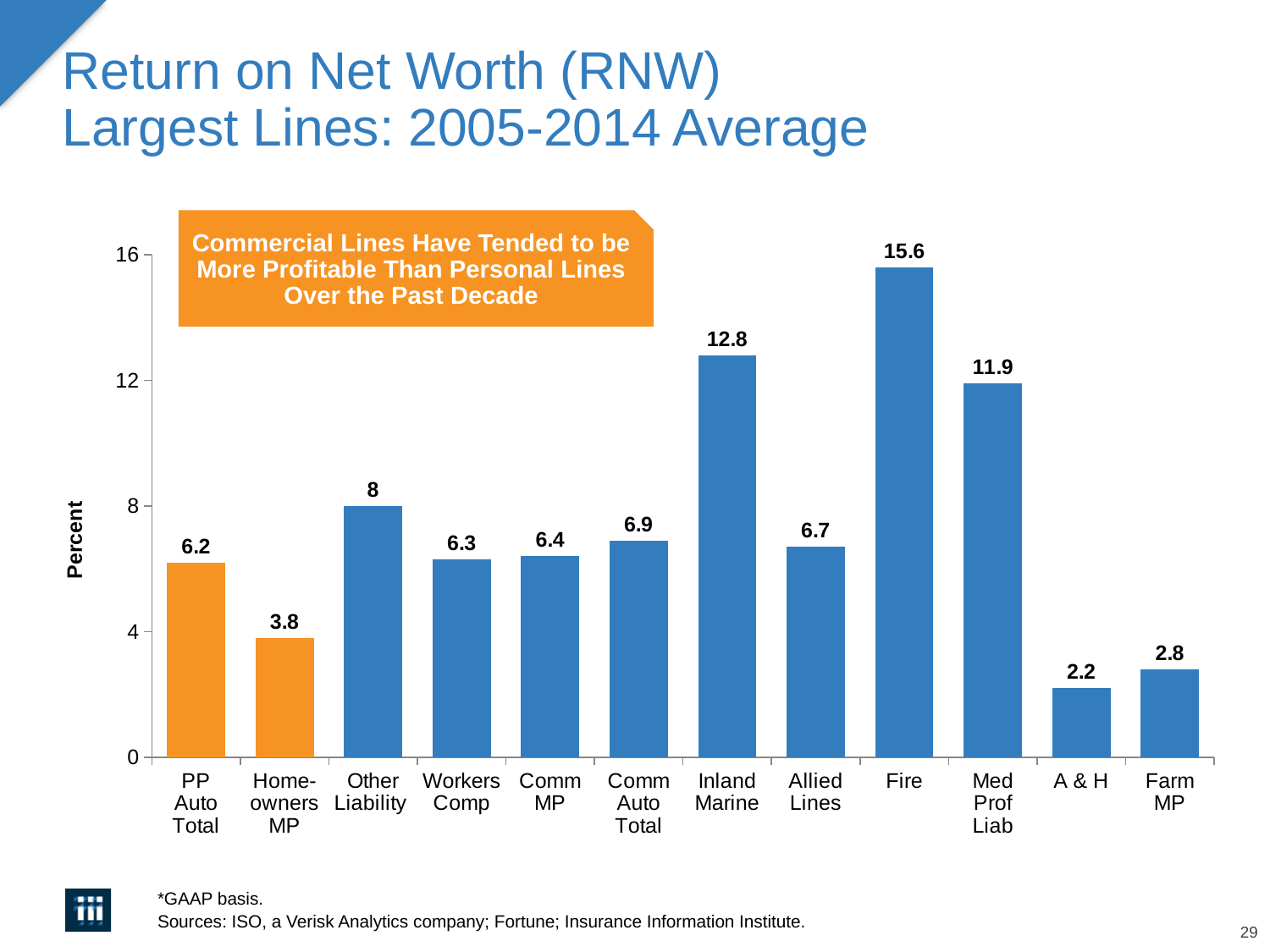
Which category has the highest value? Fire What is the value for Inland Marine? 12.8 How many categories are shown on the x axis? 12 What is the value for Homeowners MP? 3.8 Which two categories are shown with orange bars? PP Auto Total and Homeowners MP What is the label of the y axis? Percent What kind of chart is shown on the slide? bar chart Which is larger, the value for PP Auto Total or the value for Comm Auto Total? Comm Auto Total Is the value for Other Liability greater or less than 4? greater What is the difference between the values for Fire and Med Prof Liab? 3.7 What is the value for Fire? 15.6 Which category has the lowest value? A & H